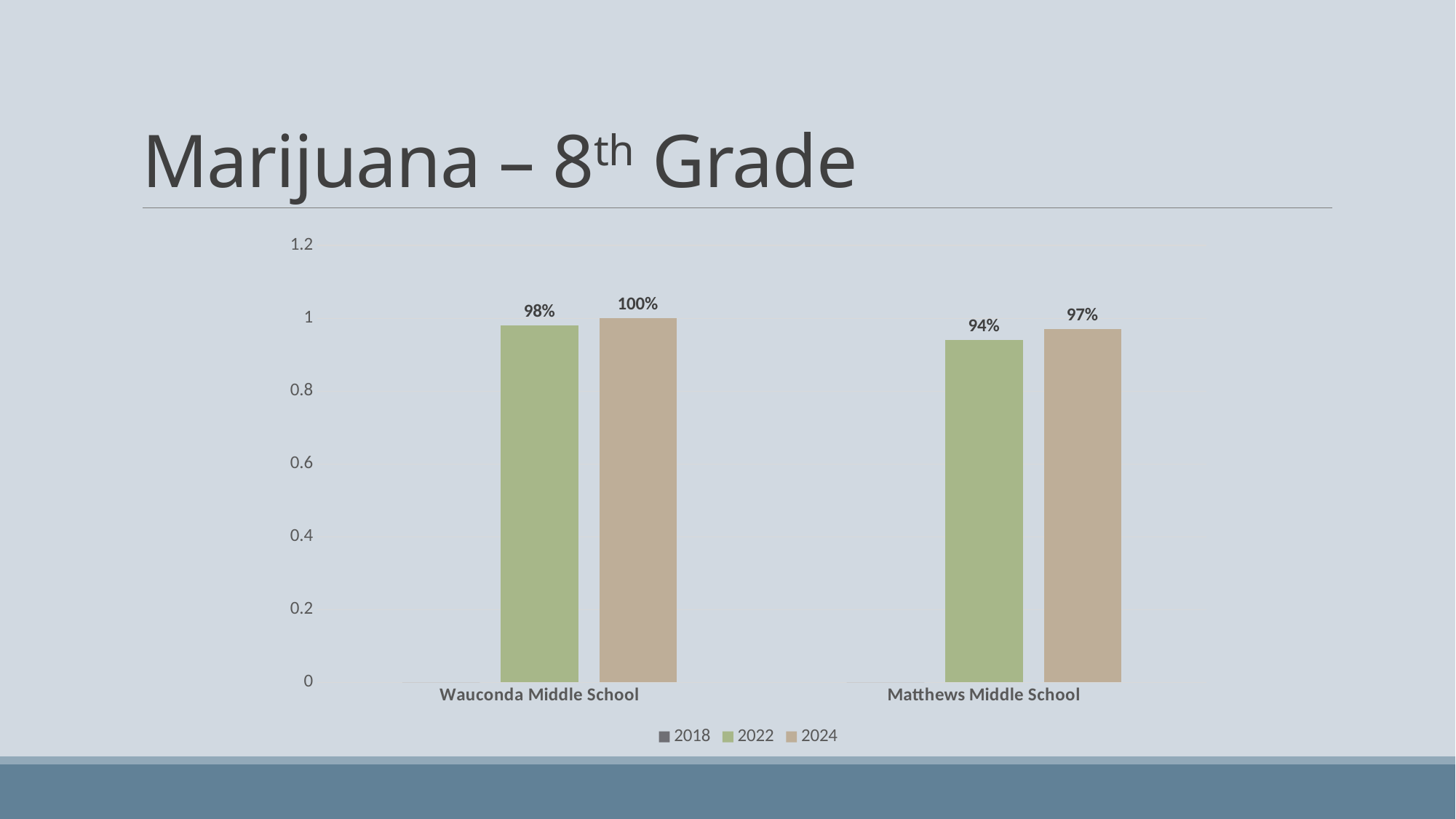
What is the 2024 value for Matthews Middle School? 97% How many schools are shown on the x axis? 2 What is the title of the slide? Marijuana – 8th Grade What is the 2024 value for Wauconda Middle School? 100% Which school has the higher 2024 value? Wauconda Middle School What kind of chart is shown on the slide? Bar chart What is the 2022 value for Wauconda Middle School? 98% What is the difference between the 2022 values for Wauconda Middle School and Matthews Middle School? 4% What is the difference between the 2024 and 2022 values for Matthews Middle School? 3% Which school has the lower 2022 value? Matthews Middle School How many series does the legend list? 3 What is the 2022 value for Matthews Middle School? 94%